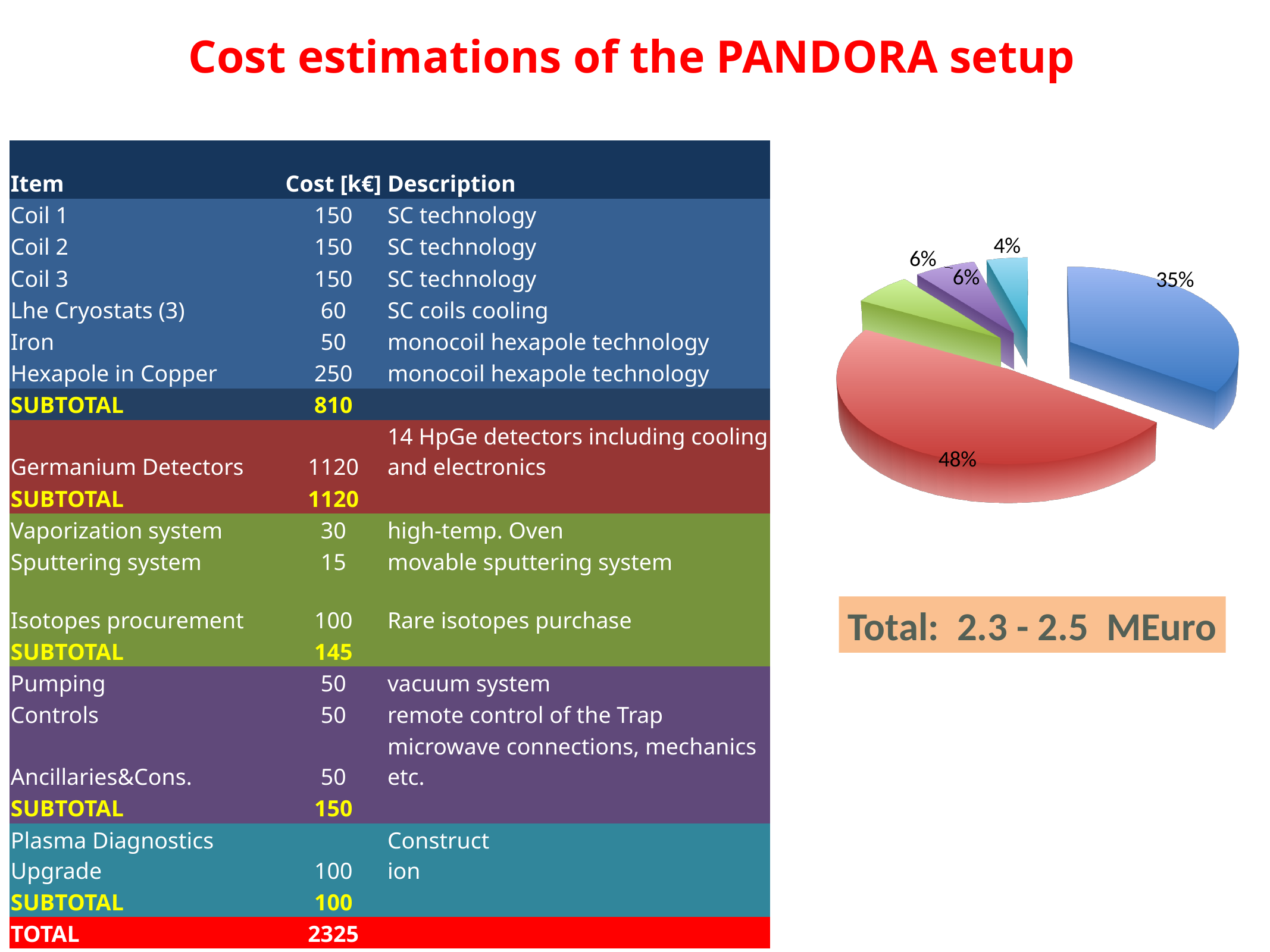
Which slice of the pie chart is larger, the red one or the blue one? red How many slices does the pie chart have? 5 What percentage is labelled on the blue slice of the pie chart? 35% What percentage is labelled on the red slice of the pie chart? 48% What is the percentage shown on the smallest slice of the pie chart? 4% What colour is the largest slice of the pie chart? red What percentage is labelled on the light blue (cyan) slice of the pie chart? 4% What do the red and blue slices of the pie chart add up to? 83% What kind of chart is shown on the right of the slide? pie chart By how many percentage points does the red slice exceed the blue slice in the pie chart? 13 How many slices of the pie chart are labelled 6%? 2 What is the percentage shown on the largest slice of the pie chart? 48%